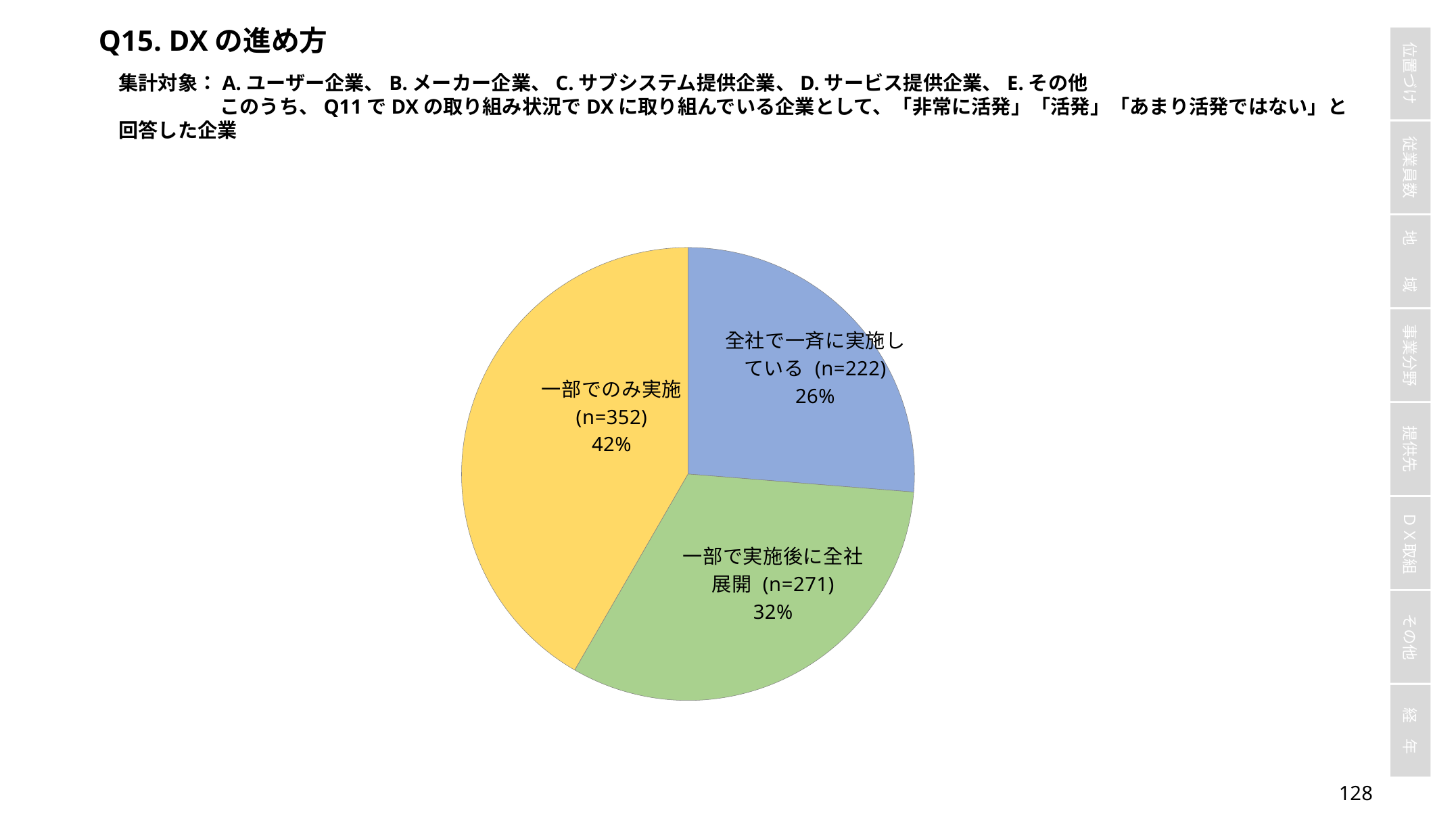
What percentage share does the slice 全社で一斉に実施している have? 26% What percentage share does the slice 一部でのみ実施 have? 42% What is the difference in percentage points between 一部でのみ実施 and 全社で一斉に実施している? 16 How many slices does the pie chart have? 3 Which colour is the slice for 一部で実施後に全社展開? green What kind of chart is shown on the slide? pie chart Which slice has the largest share? 一部でのみ実施 What is the n value shown for 一部でのみ実施? n=352 What percentage share does the slice 一部で実施後に全社展開 have? 32% What is the n value shown for 全社で一斉に実施している? n=222 Which slice has the smallest share? 全社で一斉に実施している What is the n value shown for 一部で実施後に全社展開? n=271